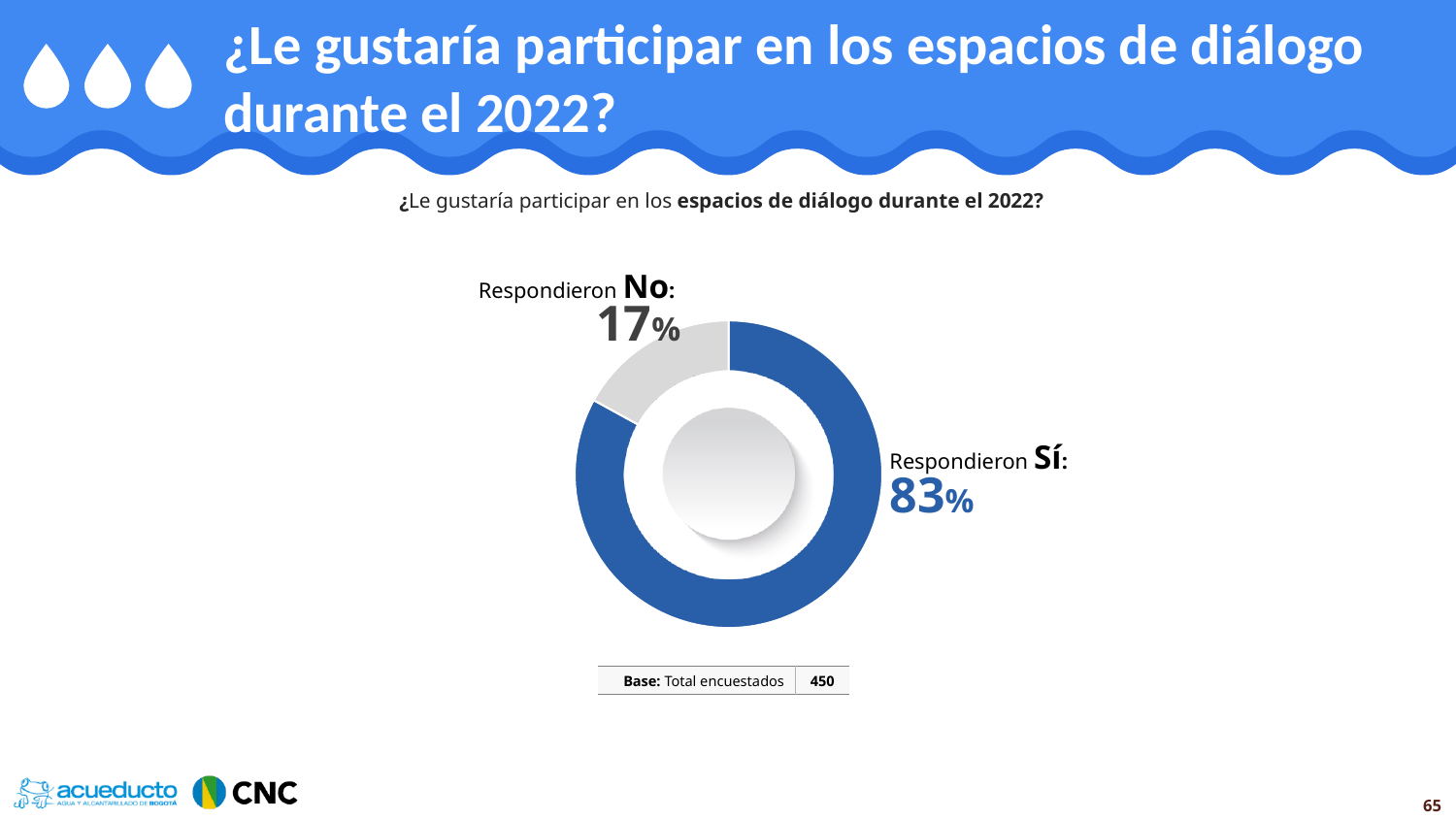
What is the base (total number of respondents) shown below the chart? 450 What colour is the segment representing the "Sí" responses? Blue Which response has the smaller share of the chart? No What percentage of respondents answered "Sí" to whether they would like to participate in the dialogue spaces during 2022? 83% What kind of chart is shown on the slide? Doughnut (pie) chart Which response has the larger share of the chart, "Sí" or "No"? Sí How many response categories does the chart show? 2 Is the share for "Sí" larger or smaller than the share for "No"? larger What is the difference in percentage points between the "Sí" and "No" responses? 66 What percentage of respondents answered "No"? 17% What is the total of the two percentages shown in the chart? 100%